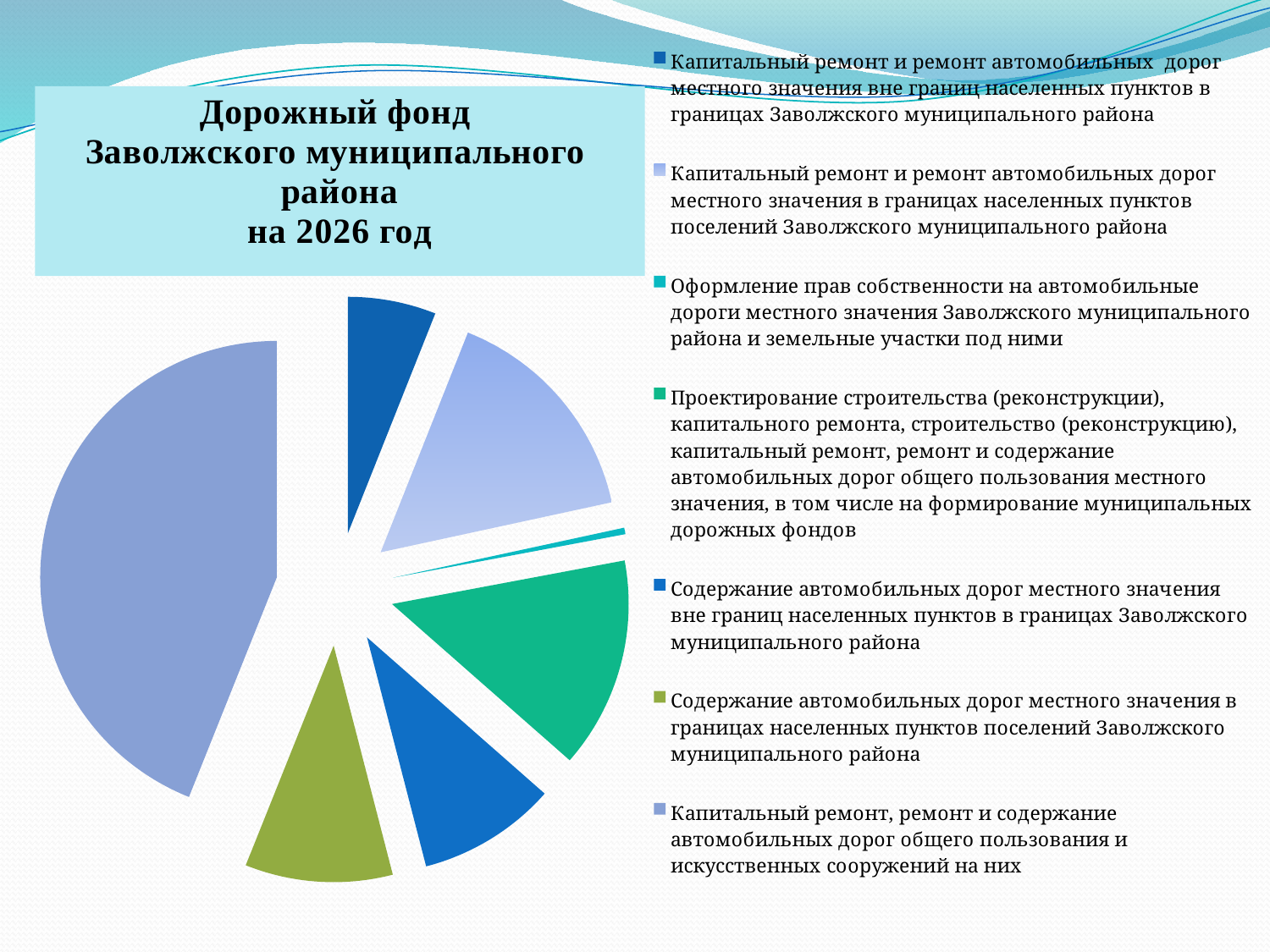
Which category has the smallest slice of the pie chart? Оформление прав собственности на автомобильные дороги местного значения Заволжского муниципального района и земельные участки под ними How many entries does the legend of the pie chart list? 7 Which slice is larger: "Оформление прав собственности на автомобильные дороги местного значения..." or "Содержание автомобильных дорог местного значения в границах населенных пунктов поселений Заволжского муниципального района"? Содержание автомобильных дорог местного значения в границах населенных пунктов поселений Заволжского муниципального района Which category has the largest slice of the pie chart? Капитальный ремонт, ремонт и содержание автомобильных дорог общего пользования и искусственных сооружений на них What colour is the largest slice of the pie chart? light blue-purple (periwinkle) How many slices does the pie chart have? 7 What kind of chart is shown on the slide? pie chart Which slice is larger: "Проектирование строительства (реконструкции), капитального ремонта..." or "Содержание автомобильных дорог местного значения вне границ населенных пунктов в границах Заволжского муниципального района"? Проектирование строительства (реконструкции), капитального ремонта... What is the title shown above the pie chart? Дорожный фонд Заволжского муниципального района на 2026 год Which slice is larger: "Капитальный ремонт и ремонт автомобильных дорог местного значения вне границ населенных пунктов в границах Заволжского муниципального района" or "Капитальный ремонт, ремонт и содержание автомобильных дорог общего пользования и искусственных сооружений на них"? Капитальный ремонт, ремонт и содержание автомобильных дорог общего пользования и искусственных сооружений на них